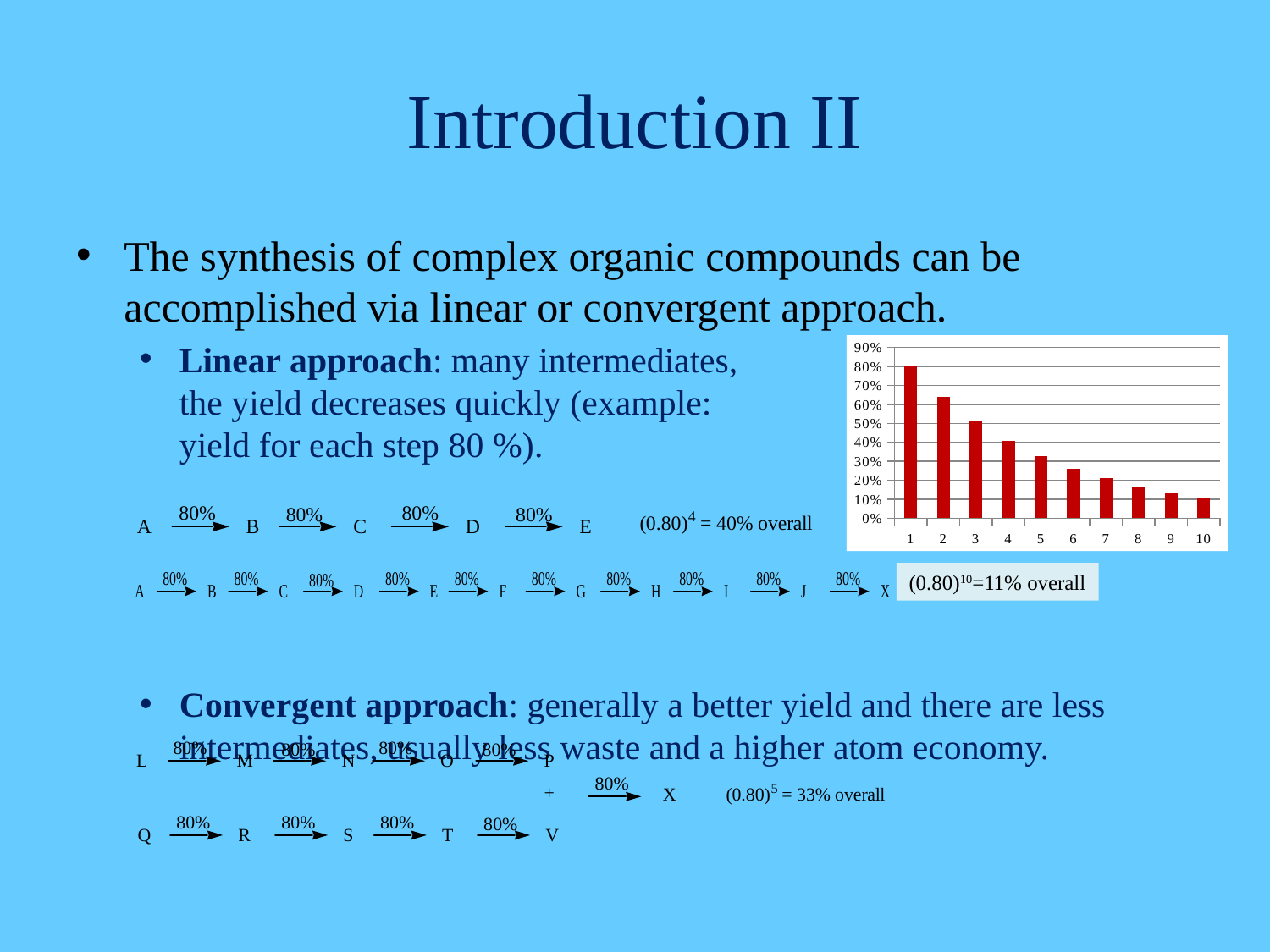
Is the value for category 10 greater or less than 20%? less What kind of chart is shown on the slide? bar chart Which category has the highest bar in the chart? 1 Which category has the lowest bar in the chart? 10 Which is larger, the value for category 2 or the value for category 5? category 2 Do the bar values rise or fall as you move from category 1 to category 10? fall What colour are the bars in the chart? red Is the value for category 6 greater or less than 30%? less What is the value for category 1 in the chart? 80% How many categories are plotted along the x axis of the chart? 10 Is the value for category 8 greater or less than 20%? less